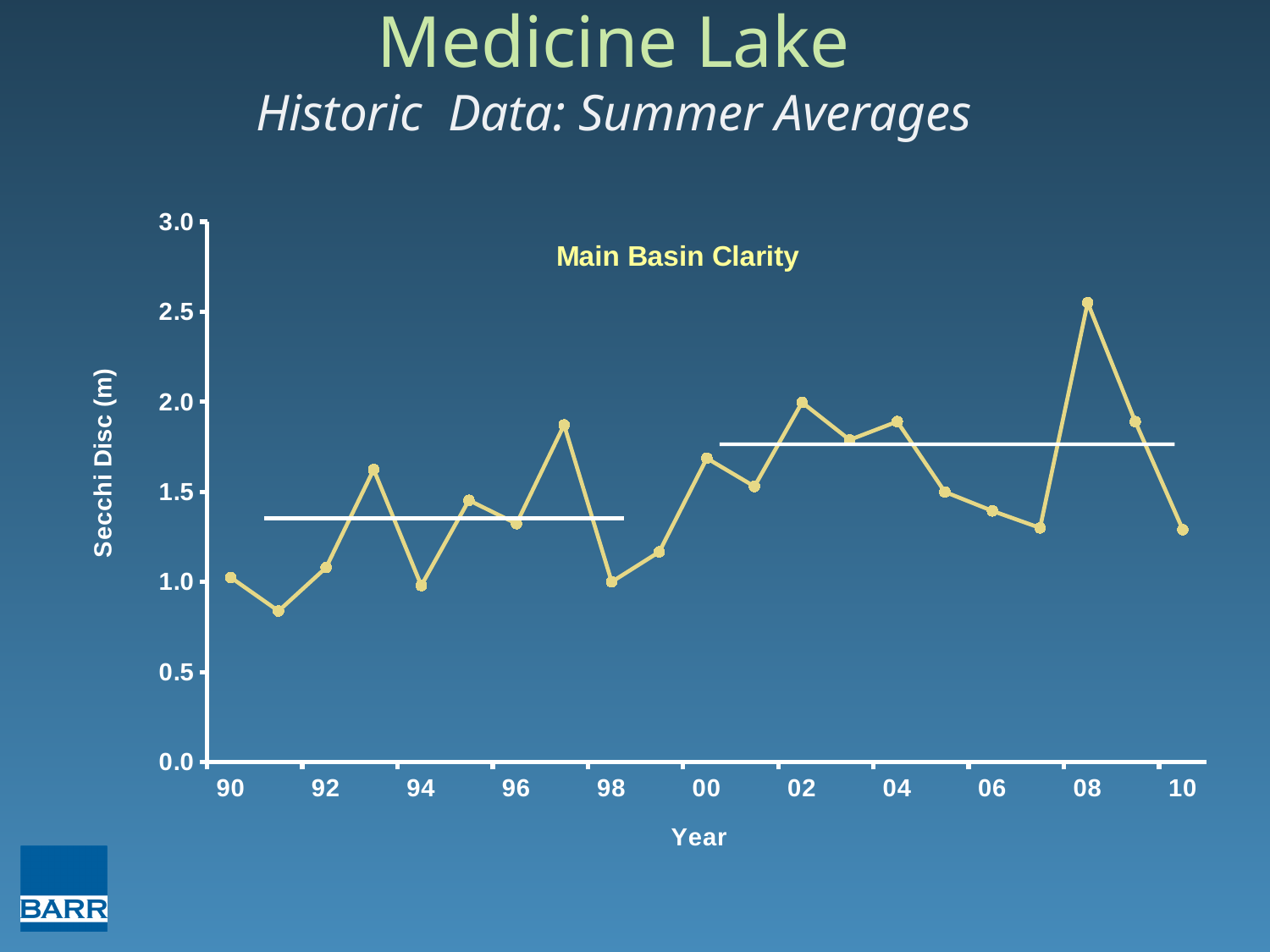
Is the value for 08 greater or less than 2.0? greater Which year has the larger Secchi disc value, 93 or 94? 93 Is the value for 07 greater or less than 1.5? less In which year is the Secchi disc value lowest? 91 What is the title printed inside the chart area? Main Basin Clarity In which year is the Secchi disc value highest? 08 What kind of chart is shown on the slide? line chart Is the value for 97 greater or less than 1.5? greater Which year has the larger Secchi disc value, 08 or 02? 08 What is the label of the vertical axis? Secchi Disc (m) How many data points are plotted on the line? 21